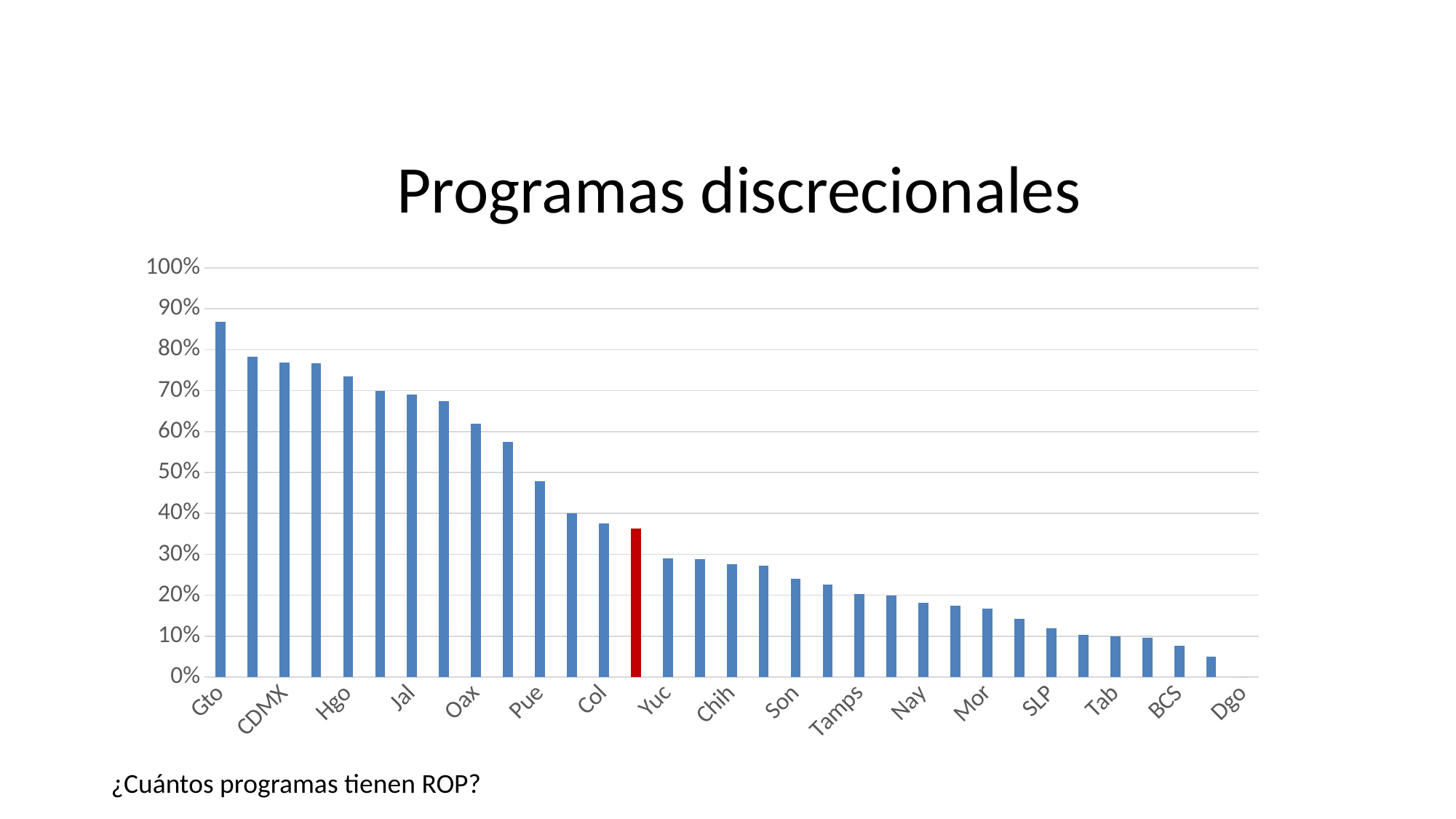
Which has a larger value, Pue or Col? Pue Which labelled category has the lowest value in the chart? Dgo Is the value for Hgo greater or less than 70%? greater Is the value for Gto greater or less than 80%? greater Is the value for Pue greater or less than 50%? less What is the title of the chart? Programas discrecionales What kind of chart is shown on the slide? bar chart Do the values rise or fall moving from left to right along the x axis? fall What colour is the single highlighted bar that differs from the others? red Which category has the highest value in the chart? Gto